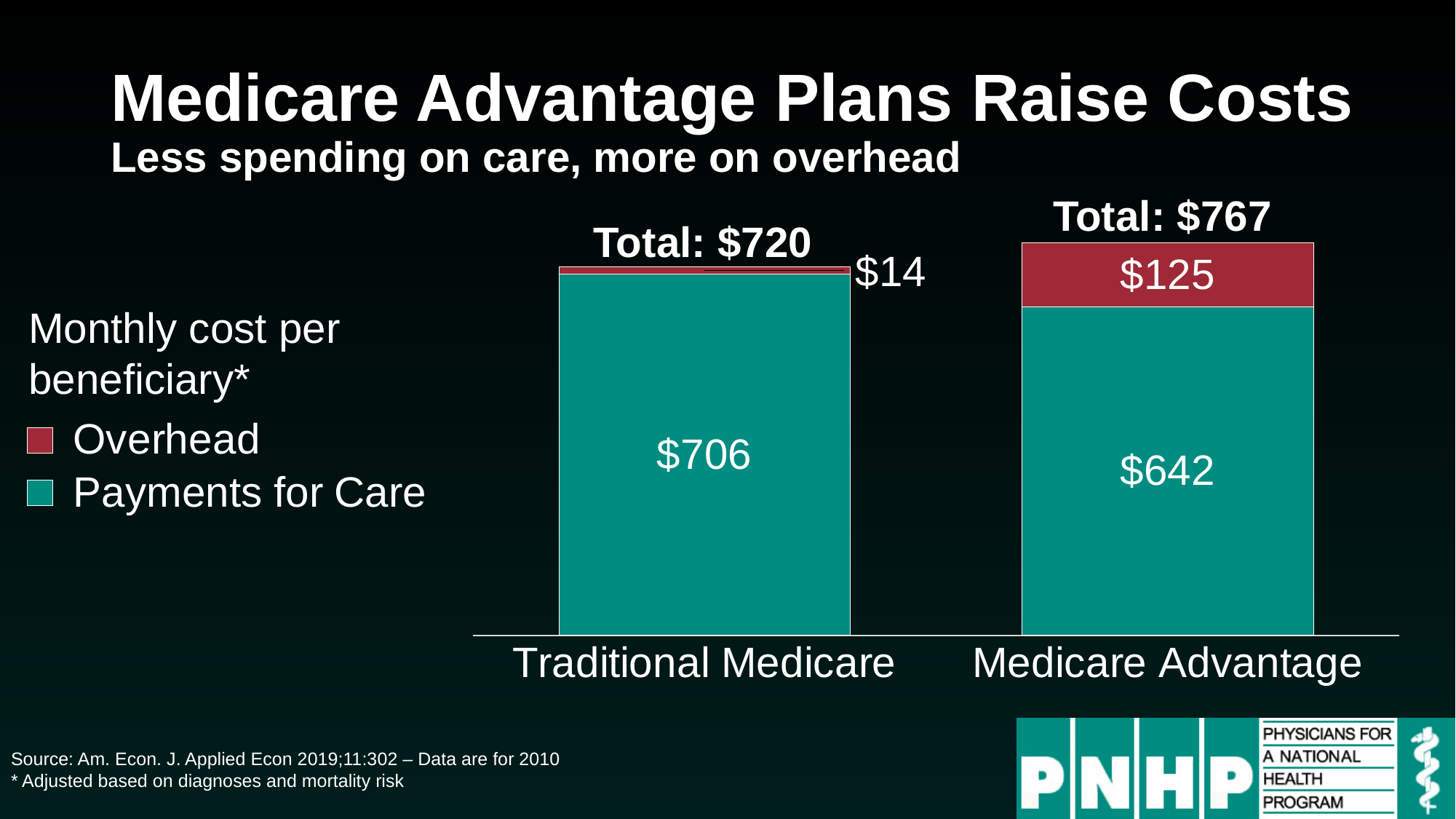
How many series does the legend list? 2 What is the Payments for Care value for Traditional Medicare? $706 Which category has the higher Overhead value? Medicare Advantage Which category has the higher Payments for Care value? Traditional Medicare What is the total monthly cost per beneficiary for Medicare Advantage? $767 What is the Overhead value for Traditional Medicare? $14 What kind of chart is shown on the slide? Stacked bar chart What is the total monthly cost per beneficiary for Traditional Medicare? $720 What is the Payments for Care value for Medicare Advantage? $642 What is the difference in Payments for Care between Traditional Medicare and Medicare Advantage? $64 What is the difference in Overhead between Medicare Advantage and Traditional Medicare? $111 What is the Overhead value for Medicare Advantage? $125